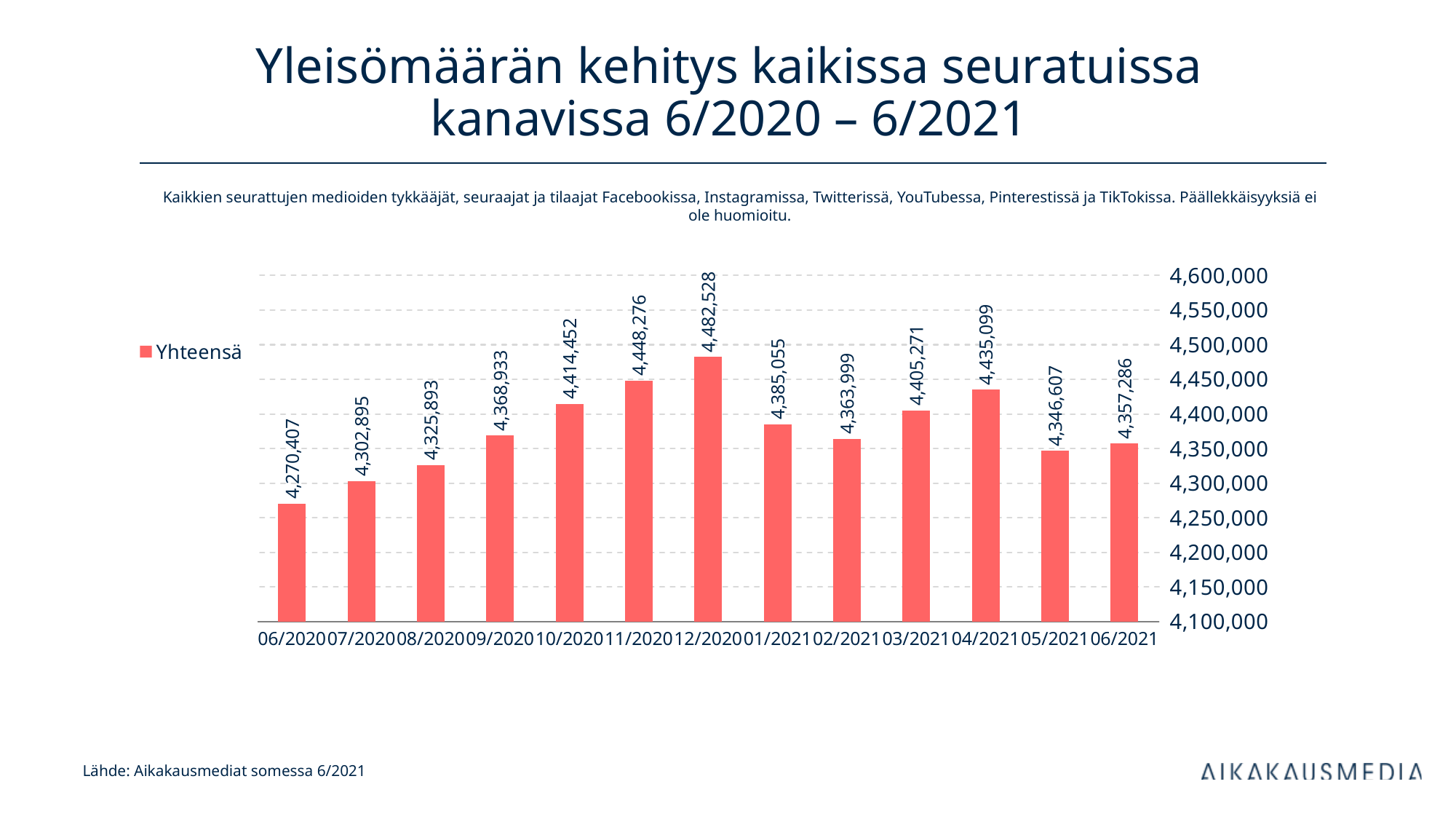
How many months are shown on the x axis? 13 Which month has the highest value? 12/2020 What is the value for 12/2020? 4,482,528 Which month has the lowest value? 06/2020 What is the value for 03/2021? 4,405,271 What is the value for 06/2020? 4,270,407 What is the difference between the values for 12/2020 and 06/2020? 212,121 What is the difference between the values for 06/2021 and 06/2020? 86,879 What kind of chart is shown on the slide? Bar chart Which is larger, the value for 04/2021 or the value for 05/2021? 04/2021 What is the name of the series shown in the legend? Yhteensä What is the value for 06/2021? 4,357,286